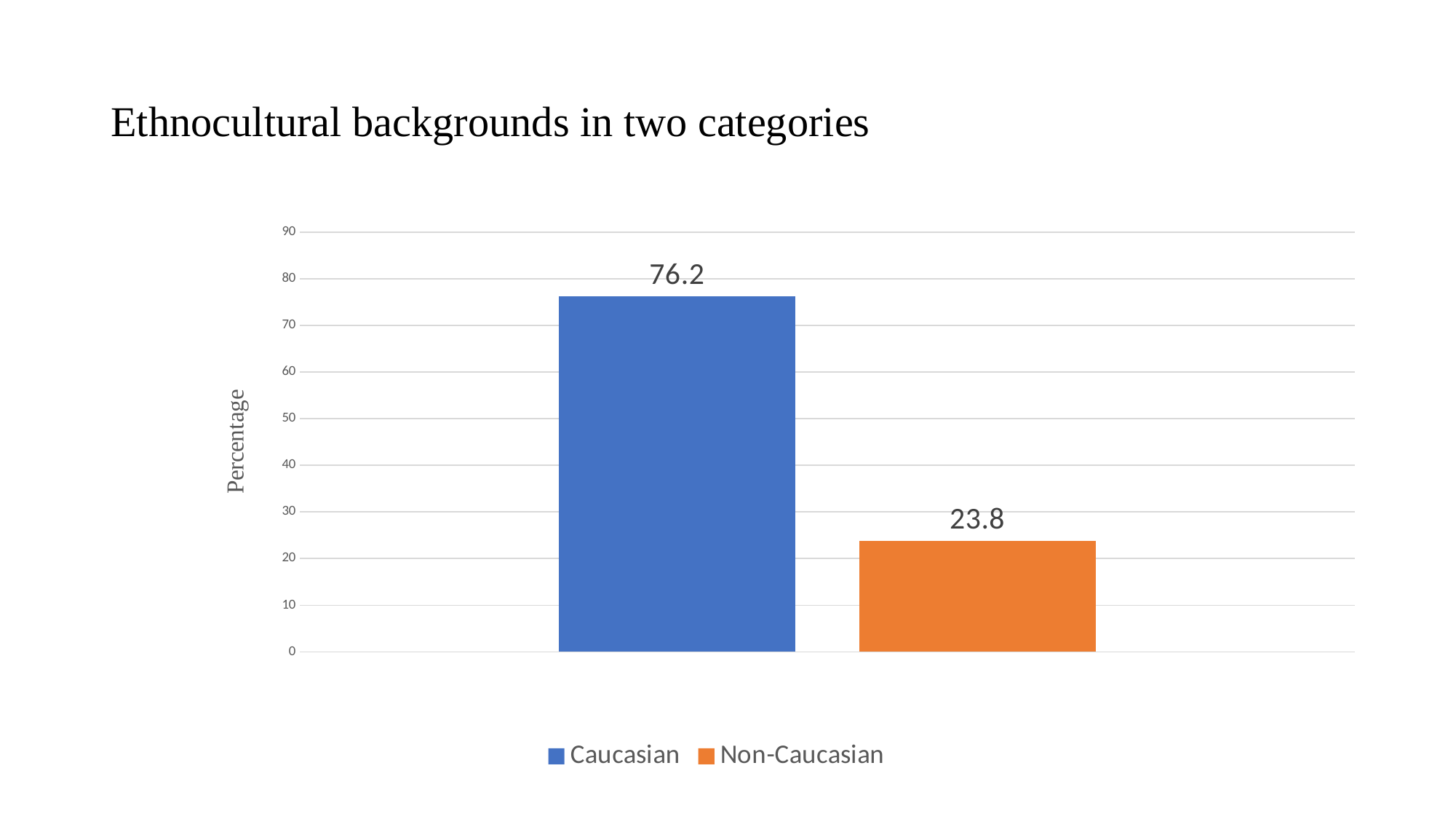
How many bars are plotted in the chart? 2 What is the difference between the Caucasian and Non-Caucasian values? 52.4 What is the label on the vertical axis? Percentage Which is larger, the value for Caucasian or the value for Non-Caucasian? Caucasian Is the value for Caucasian greater or less than 70? greater Which category has the highest value? Caucasian How many entries does the legend list? 2 What is the value for Non-Caucasian? 23.8 Is the value for Non-Caucasian greater or less than 30? less Which category has the lowest value? Non-Caucasian What is the value for Caucasian? 76.2 What kind of chart is shown on the slide? Bar chart